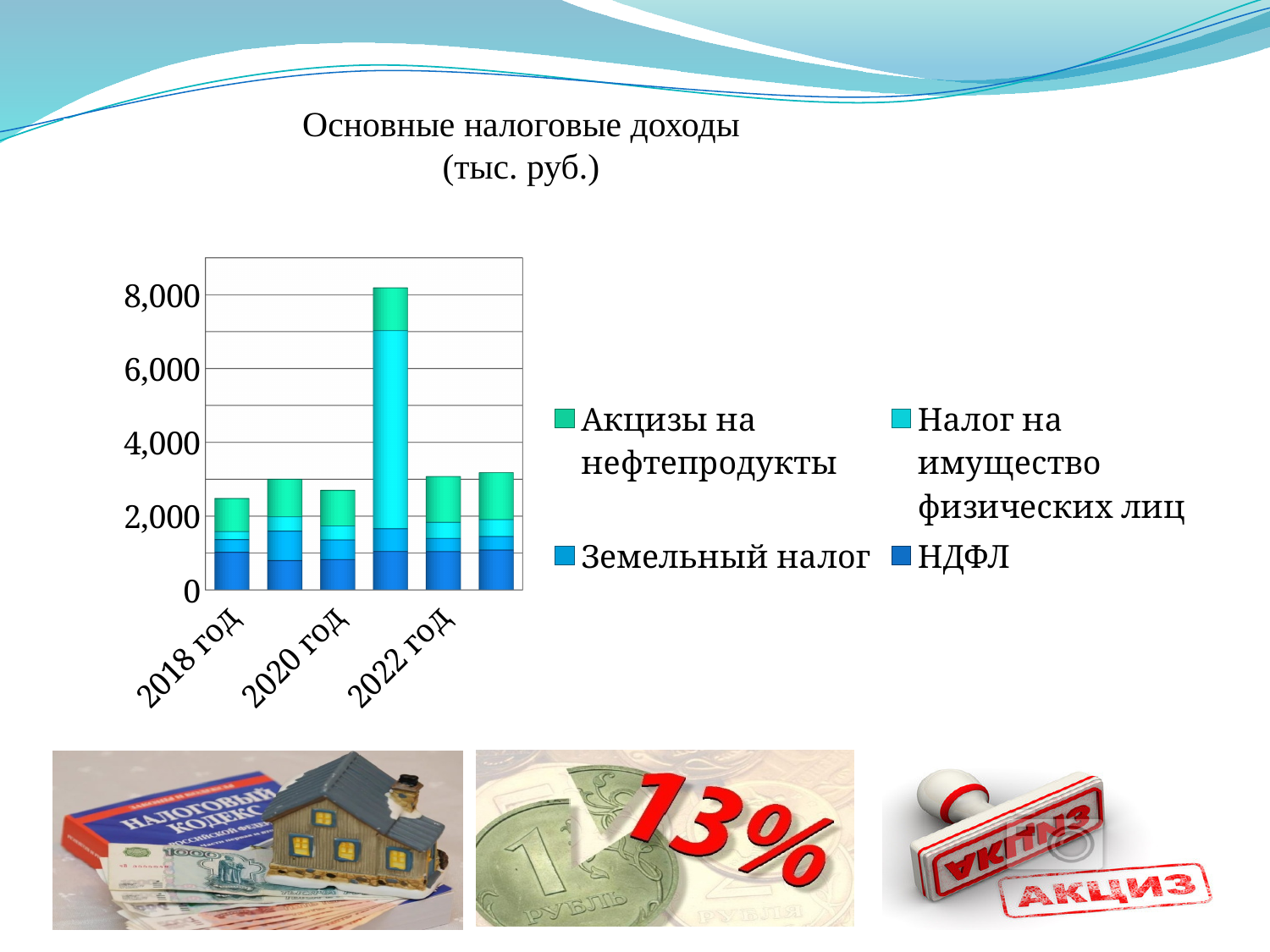
Which series is shown at the bottom of each stacked bar? НДФЛ What kind of chart is shown on the slide? stacked bar chart Which has the larger total, 2018 год or 2022 год? 2022 год How many series does the chart legend list? 4 Is the total for 2020 год greater or less than 4,000? less Among the labelled years 2018 год, 2020 год and 2022 год, which has the highest total? 2022 год Is the total for 2022 год greater or less than 4,000? less Is the tallest bar in the chart greater or less than 8,000? greater What is the title of the chart? Основные налоговые доходы (тыс. руб.) How many bars are plotted in the chart? 6